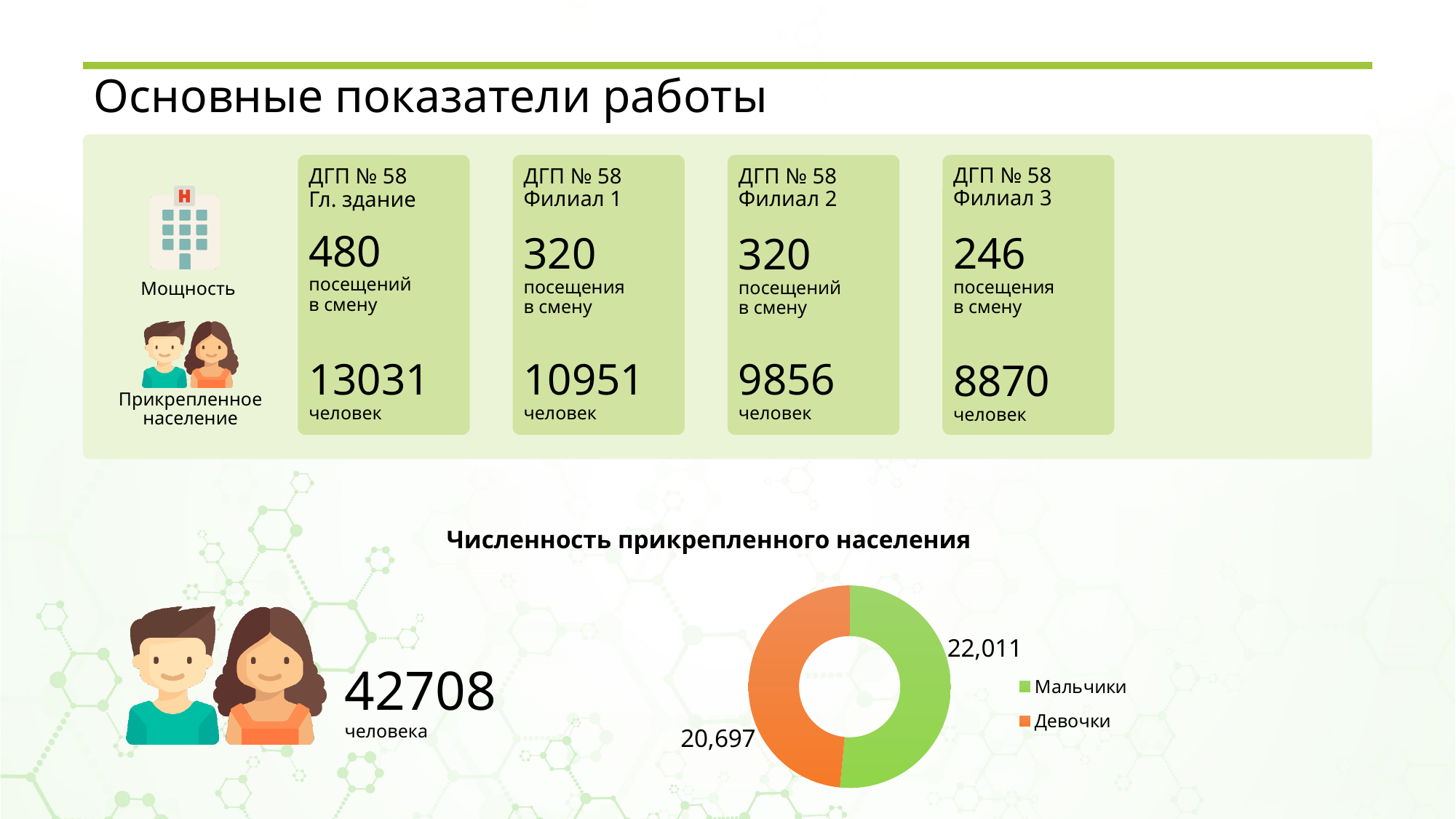
Which category has the largest slice in the doughnut chart? Мальчики Which category has the smallest slice in the doughnut chart? Девочки How many categories does the doughnut chart show? 2 How many entries does the legend of the doughnut chart list? 2 What is the value for Мальчики in the doughnut chart? 22,011 What is the difference between the values for Мальчики and Девочки in the doughnut chart? 1,314 What is the value for Девочки in the doughnut chart? 20,697 What colour is the Девочки slice in the doughnut chart? Orange Which is larger in the doughnut chart, Мальчики or Девочки? Мальчики What is the total of the two slices in the doughnut chart? 42,708 What kind of chart is shown on the slide? Doughnut (pie) chart What is the title of the doughnut chart? Численность прикрепленного населения